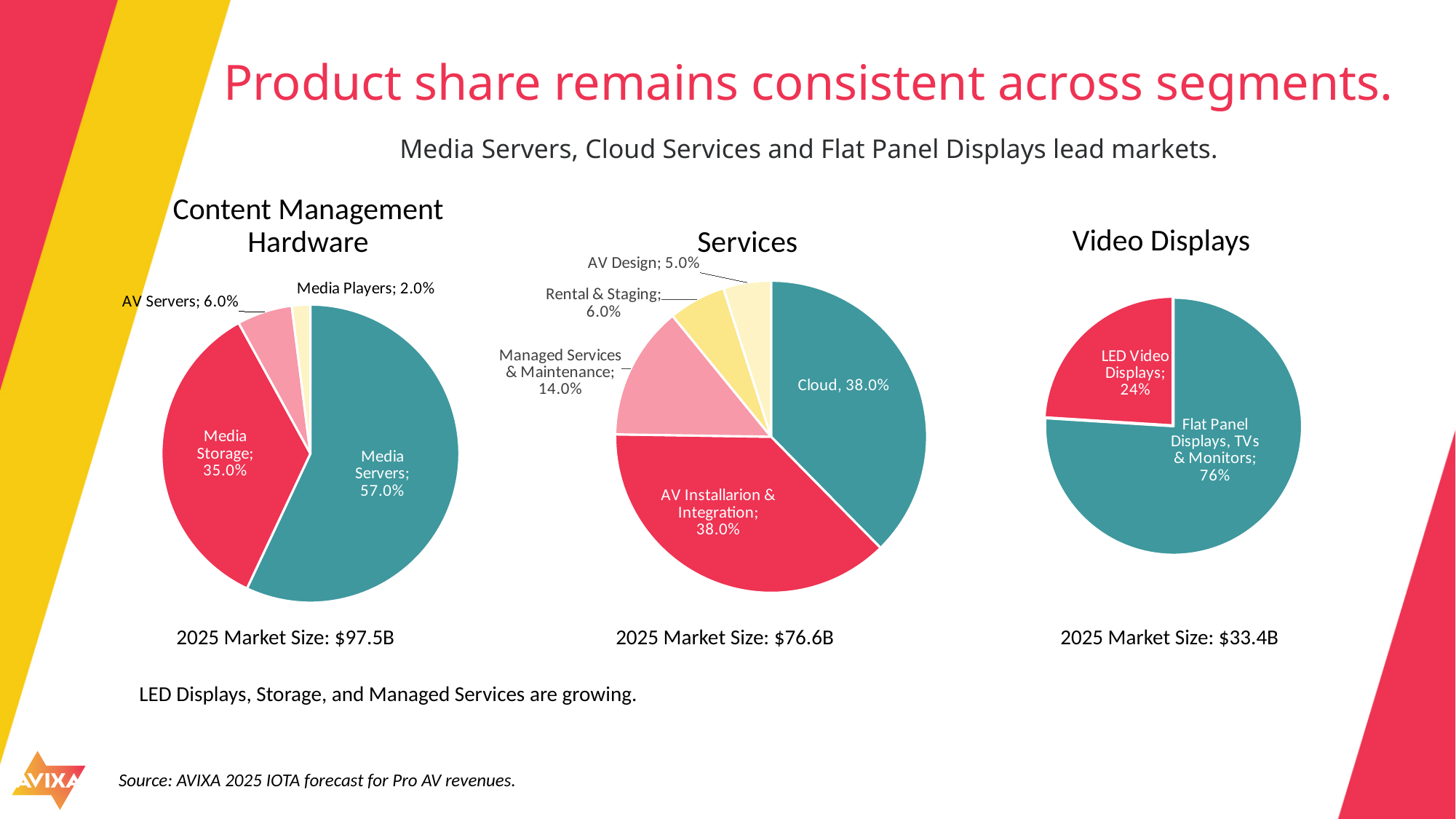
What is the 2025 market size shown under the Services chart? $76.6B How many slices does the Services pie chart have? 5 How many slices does the Content Management Hardware pie chart have? 4 In the Content Management Hardware chart, what is the difference between the Media Servers and Media Storage shares? 22.0% What kind of chart is used for Video Displays? Pie chart In the Video Displays chart, what share do LED Video Displays hold? 24% In the Services chart, which category has the smallest share? AV Design In the Content Management Hardware chart, which category has the smallest share? Media Players In the Services chart, what share does Managed Services & Maintenance hold? 14.0% In the Content Management Hardware chart, what share do Media Servers hold? 57.0% In the Services chart, which is larger: Rental & Staging or AV Design? Rental & Staging In the Video Displays chart, which category has the largest share? Flat Panel Displays, TVs & Monitors